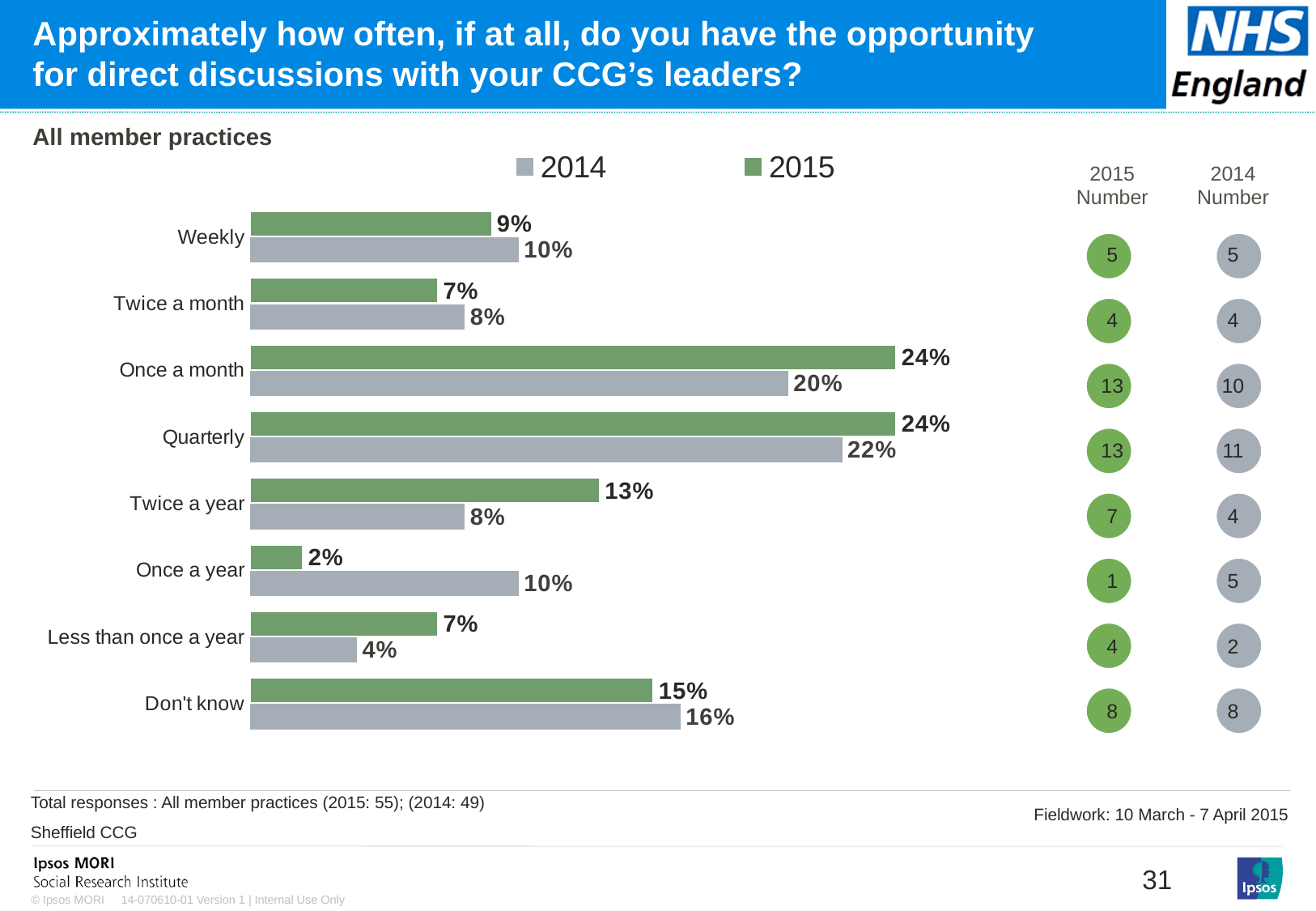
Which category has the highest value for the 2014 series? Quarterly How many response categories are shown on the chart? 8 Which category has the lowest value for the 2015 series? Once a year Which category has the lowest value for the 2014 series? Less than once a year Which is larger for 'Once a year': the 2014 value or the 2015 value? 2014 What percentage of member practices said they have the opportunity for direct discussions with CCG leaders once a month in 2015? 24% Which colour represents the 2015 series in the chart? Green What was the 2015 value for 'Once a year'? 2% What is the difference between the 2015 and 2014 values for 'Twice a year'? 5 percentage points How many series does the legend list? 2 What was the 2014 value for 'Twice a year'? 8% What type of chart is shown on the slide? Bar chart